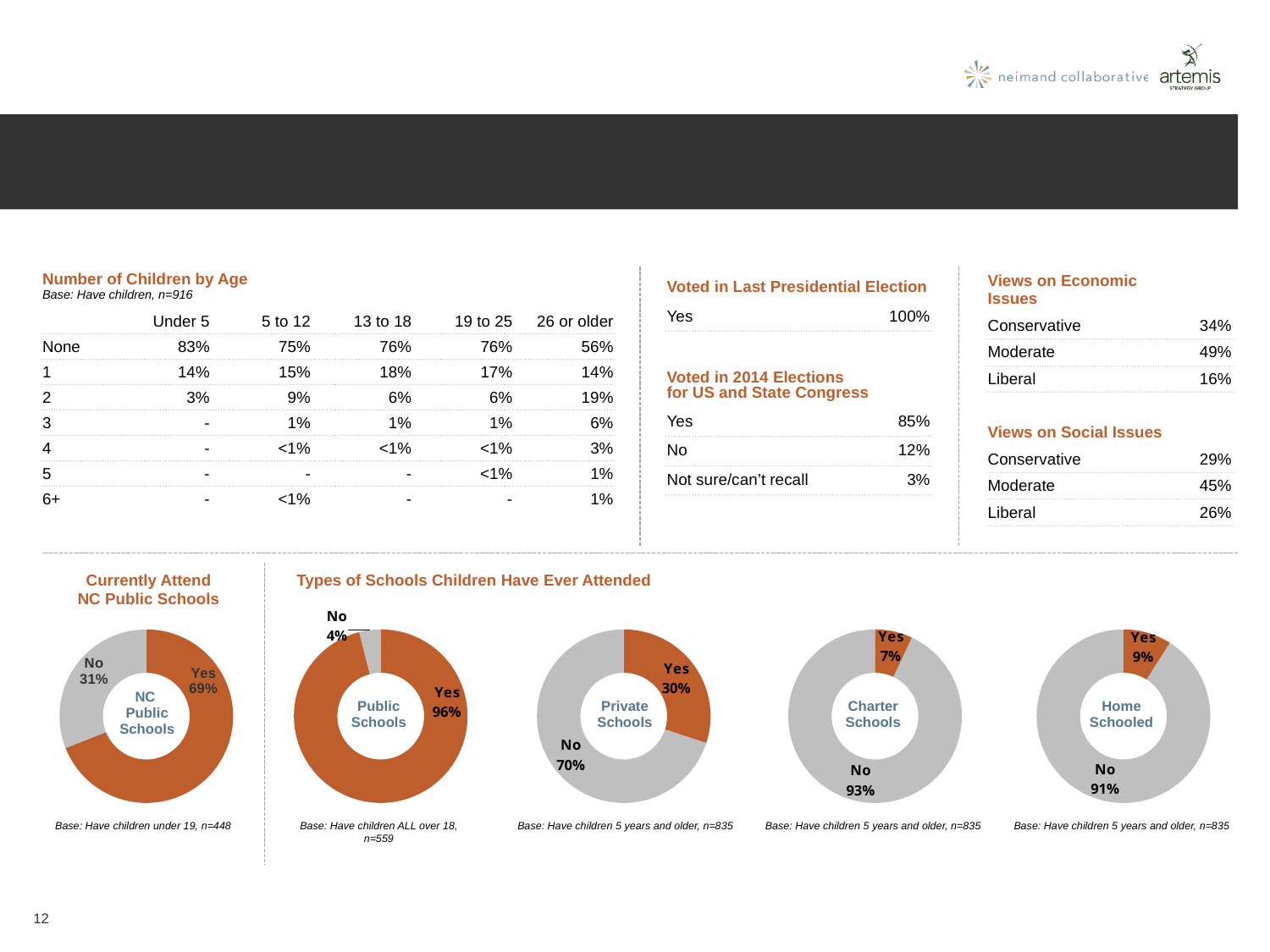
Among the four 'Types of Schools Children Have Ever Attended' donut charts, which school type has the highest Yes share? Public Schools In the 'Home Schooled' donut chart, what percentage answered No? 91% Among the four 'Types of Schools Children Have Ever Attended' donut charts, which school type has the lowest Yes share? Charter Schools What kind of chart is used for 'Currently Attend NC Public Schools'? Donut (pie) chart In the 'Public Schools' donut chart under 'Types of Schools Children Have Ever Attended', what percentage answered Yes? 96% In the 'Currently Attend NC Public Schools' chart, what share of respondents answered Yes? 69% In the 'Private Schools' donut chart, what percentage answered No? 70% How many donut charts are shown under the heading 'Types of Schools Children Have Ever Attended'? 4 In the 'Private Schools' donut chart, which response is larger, Yes or No? No In the 'Charter Schools' donut chart, what percentage answered Yes? 7% In the 'Currently Attend NC Public Schools' chart, what is the difference between the Yes and No shares? 38 percentage points In the 'Currently Attend NC Public Schools' chart, what share of respondents answered No? 31%